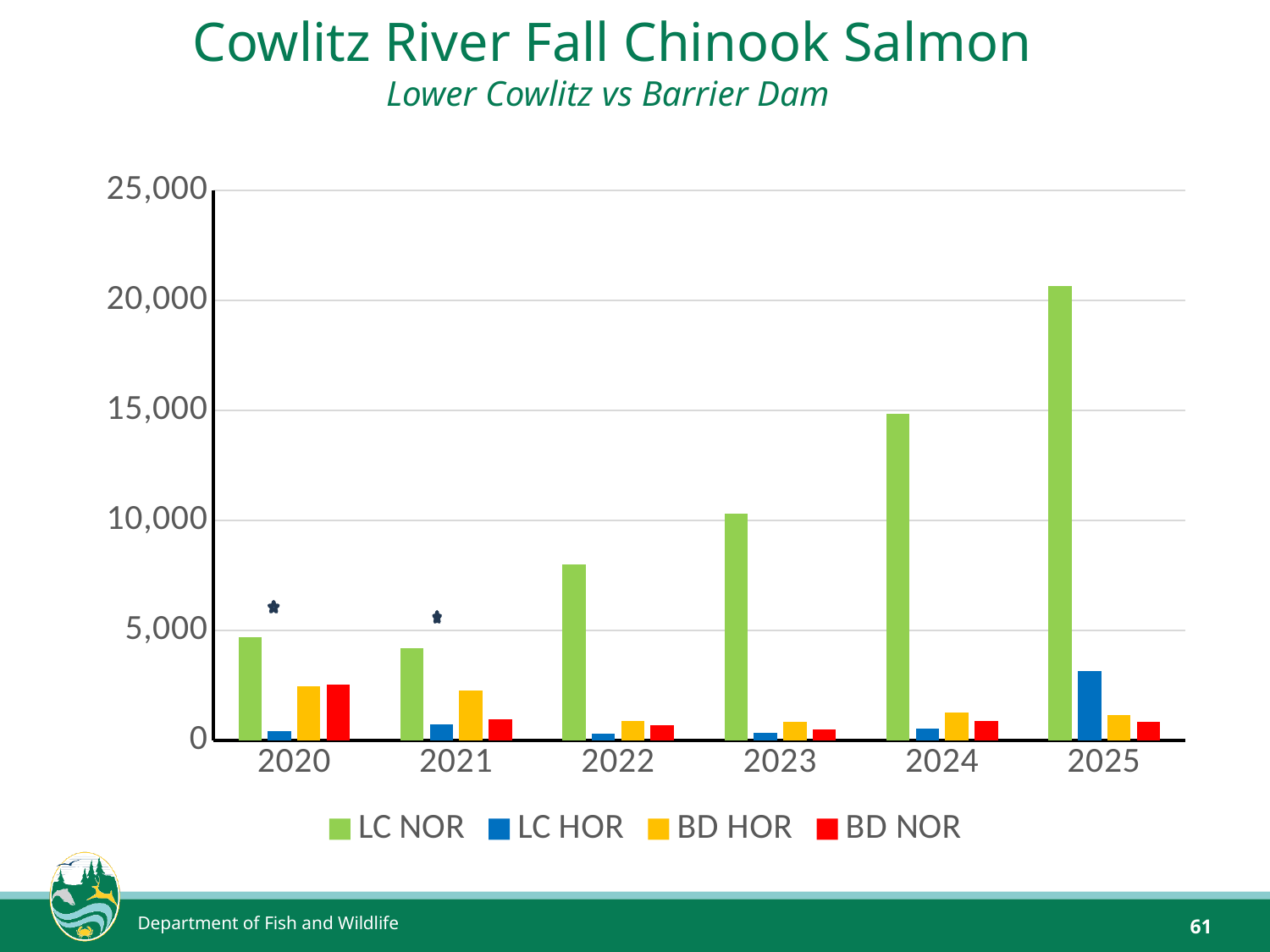
In 2025, which is larger, LC HOR or BD HOR? LC HOR Is the BD HOR value for 2020 greater or less than 5,000? less What is the subtitle of the chart? Lower Cowlitz vs Barrier Dam Do the LC NOR values rise or fall from 2022 to 2025? rise How many years are shown on the x axis of the chart? 6 Is the LC NOR value for 2022 greater or less than 10,000? less What kind of chart is shown on the slide? bar chart In 2020, which is larger, LC NOR or BD NOR? LC NOR Which year has the highest LC HOR value? 2025 How many series does the legend list? 4 Is the LC NOR value for 2025 greater or less than 20,000? greater Which year has the highest LC NOR value? 2025